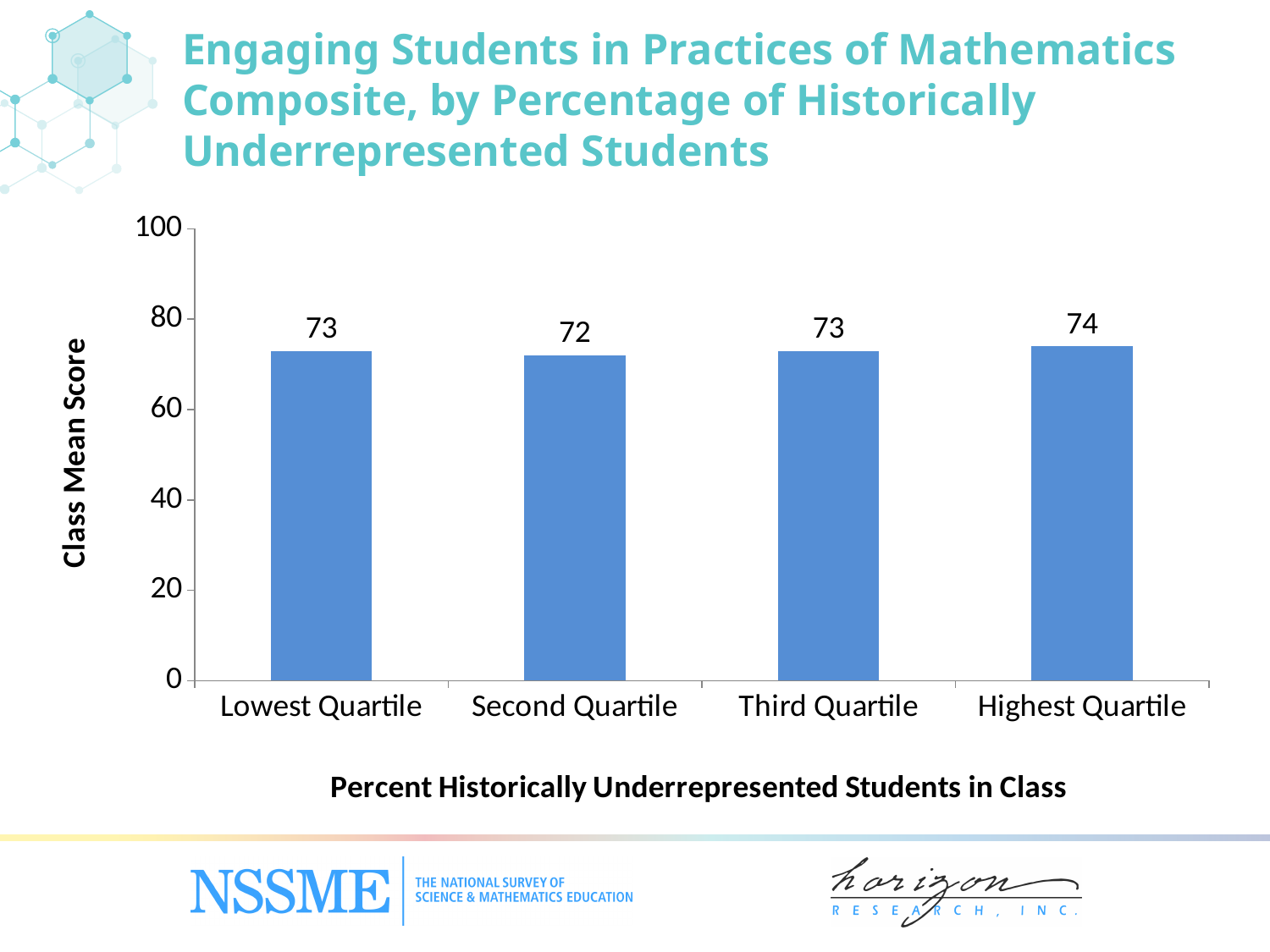
What is the class mean score for the Lowest Quartile? 73 What is the class mean score for the Second Quartile? 72 What is the class mean score for the Highest Quartile? 74 Is the class mean score for the Third Quartile greater or less than 60? greater What is the difference between the class mean scores of the Highest Quartile and the Second Quartile? 2 How many quartile categories are shown on the x axis? 4 What is the label of the y axis? Class Mean Score What kind of chart is shown on the slide? Bar chart What is the label of the x axis? Percent Historically Underrepresented Students in Class What is the class mean score for the Third Quartile? 73 Which quartile has the lowest class mean score? Second Quartile Which quartile has the highest class mean score? Highest Quartile